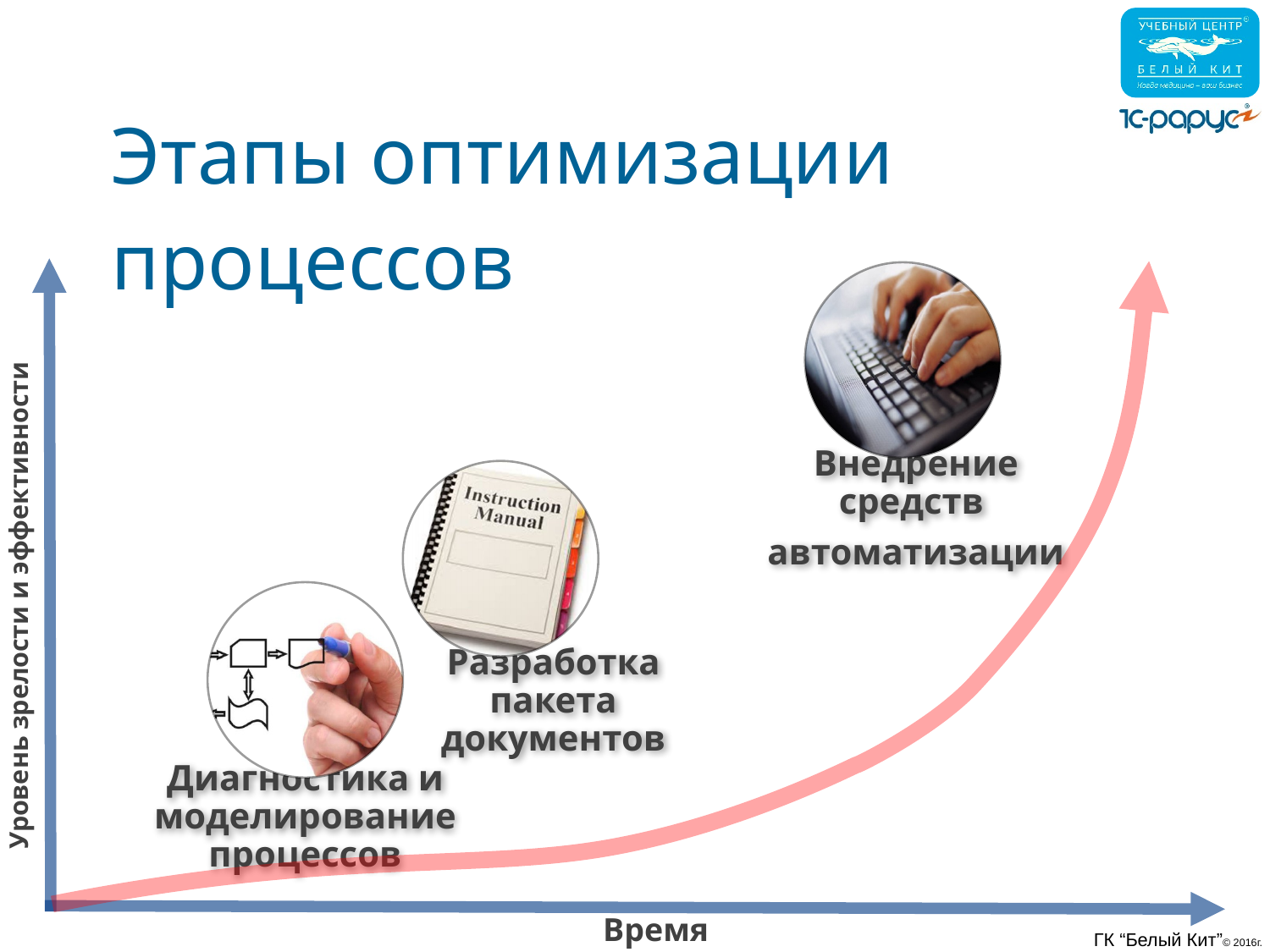
Which stage is placed highest on the curve? Внедрение средств автоматизации Does the curve on the chart rise or fall as it moves along the time axis? rise Which stage is placed higher on the curve: "Разработка пакета документов" or "Диагностика и моделирование процессов"? Разработка пакета документов Which stage is placed lowest on the curve? Диагностика и моделирование процессов How many stages are marked along the curve on the chart? 3 What is the title of the chart on the slide? Этапы оптимизации процессов What is the label of the horizontal axis of the chart? Время